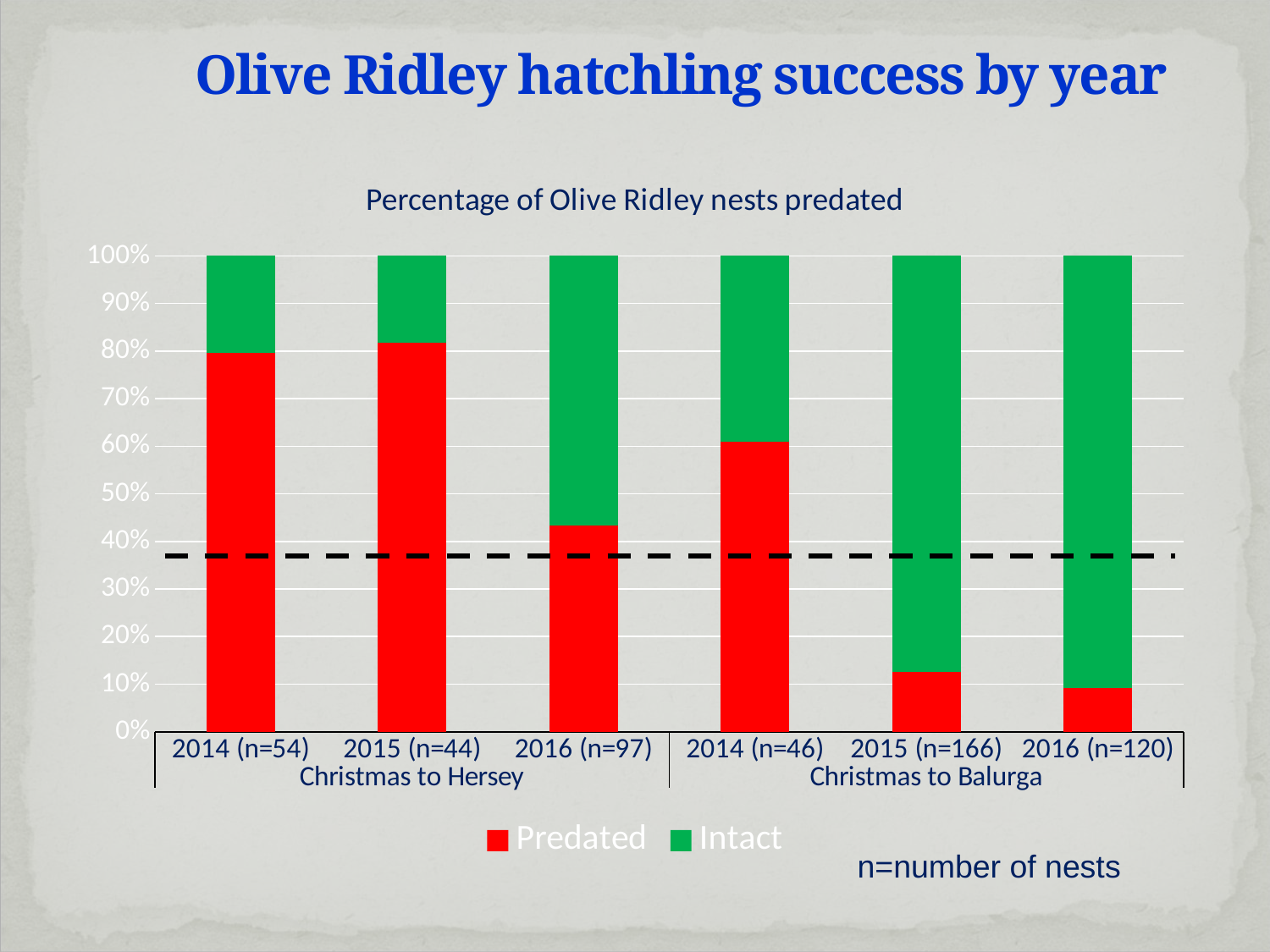
What is the title of the chart? Percentage of Olive Ridley nests predated Is the Predated value for 2014 (n=46) under Christmas to Balurga greater or less than 50%? greater Is the Predated value for 2015 (n=166) under Christmas to Balurga greater or less than 20%? less How many bars (year categories) are plotted in the chart? 6 What kind of chart is shown on the slide? Stacked bar chart Is the Predated value for 2014 (n=54) under Christmas to Hersey greater or less than 70%? greater How many series does the legend list? 2 Which category has the lowest Predated percentage? 2016 (n=120), Christmas to Balurga Within Christmas to Balurga, does the Predated percentage rise or fall from 2014 to 2016? Fall Which colour represents the Predated series in the chart? Red Which has the larger Predated percentage: 2014 (n=54) under Christmas to Hersey or 2014 (n=46) under Christmas to Balurga? 2014 (n=54), Christmas to Hersey